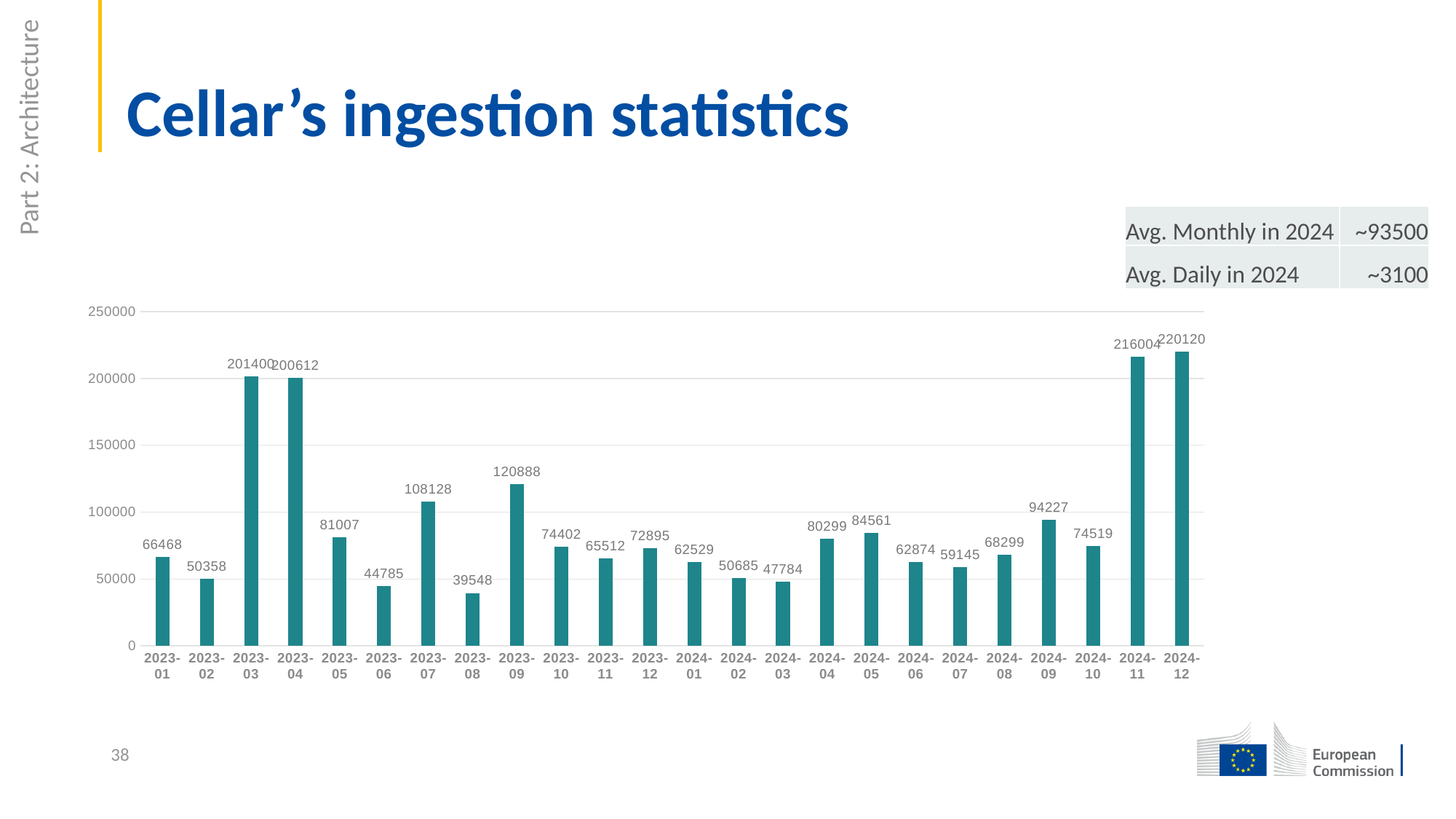
What is the difference between the values for 2023-09 and 2023-07? 12760 What is the value for 2023-09? 120888 Which month has the highest value? 2024-12 How many months are shown on the x axis? 24 Which month has the lowest value? 2023-08 Which is larger, the value for 2024-09 or the value for 2024-10? 2024-09 What kind of chart is shown on the slide? Bar chart What is the value for 2023-06? 44785 Is the value for 2023-04 greater or less than 150000? greater What is the difference between the values for 2024-12 and 2024-11? 4116 What is the value for 2024-11? 216004 What is the title of the slide containing the chart? Cellar's ingestion statistics